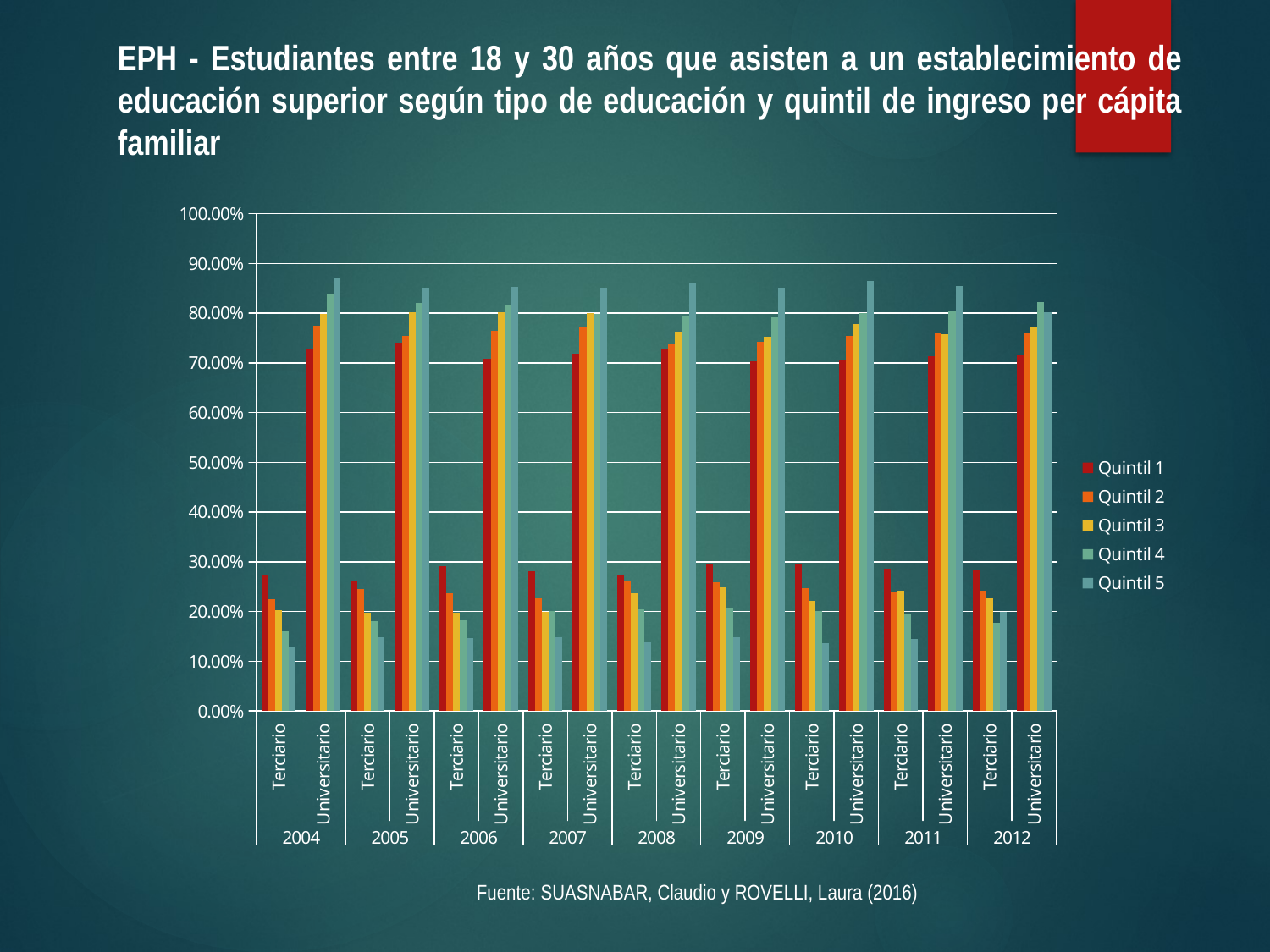
Is the value for Quintil 1 in Terciario 2004 greater or less than 20.00%? greater In Terciario 2004, which is larger: Quintil 1 or Quintil 5? Quintil 1 In Universitario 2004, which quintil has the highest value? Quintil 5 How many series does the legend list? 5 Is the value for Quintil 5 in Universitario 2004 greater or less than 80.00%? greater How many years are shown along the x axis? 9 Which years does the x axis cover, from first to last? 2004 to 2012 What kind of chart is shown on the slide? bar chart In Universitario 2004, which is larger: Quintil 1 or Quintil 5? Quintil 5 Is the value for Quintil 1 in Universitario 2004 greater or less than 60.00%? greater In Terciario 2004, which quintil has the lowest value? Quintil 5